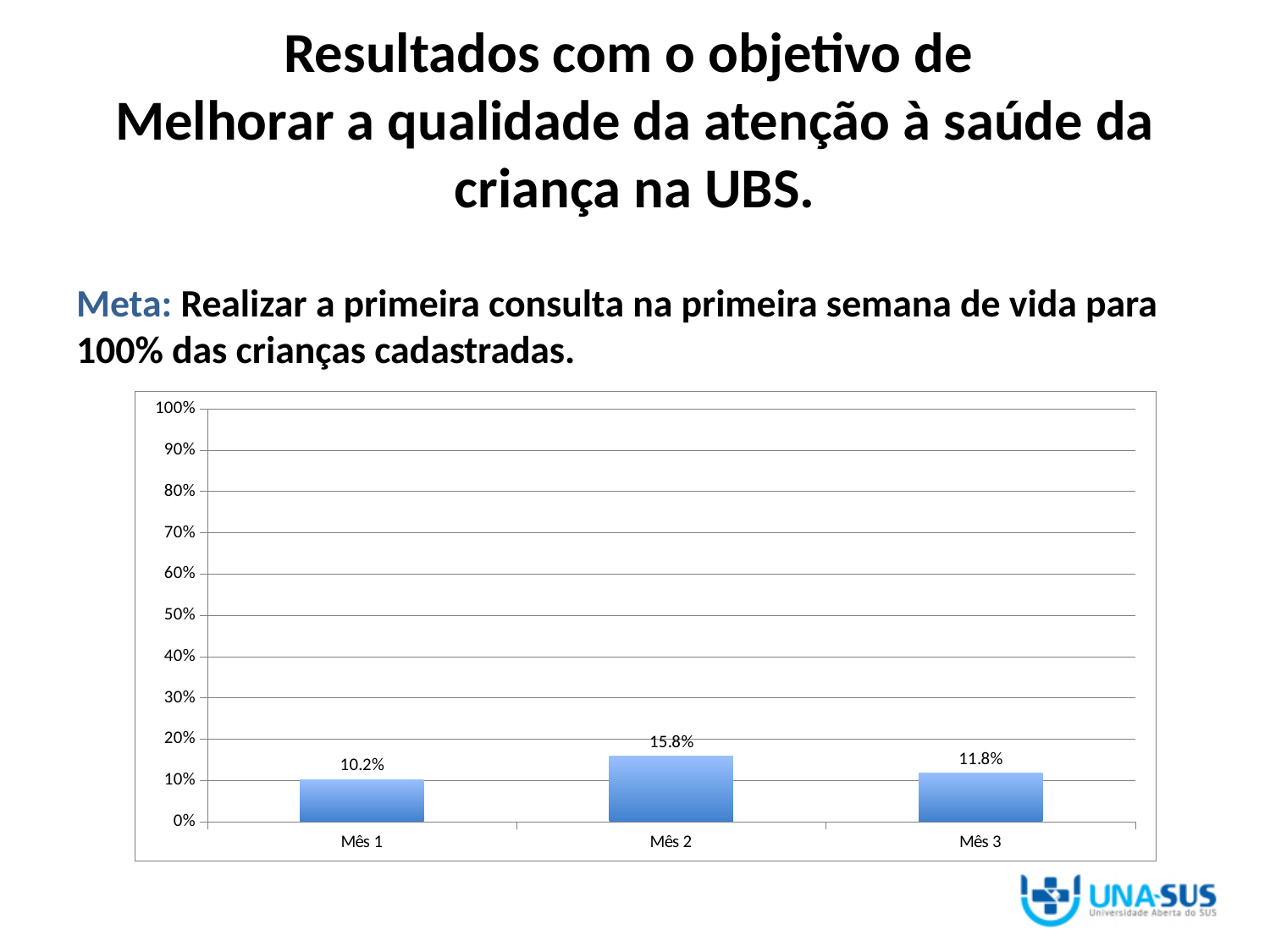
What kind of chart is shown on the slide? bar chart How many months are shown on the x axis? 3 Is the value for Mês 2 greater or less than 20%? less What is the maximum value shown on the y axis? 100% Which is larger, the value for Mês 3 or the value for Mês 1? Mês 3 What is the difference between the values for Mês 2 and Mês 1? 5.6% What is the difference between the values for Mês 2 and Mês 3? 4.0% Which month has the lowest value? Mês 1 What is the value for Mês 1? 10.2% What is the value for Mês 3? 11.8% What is the value for Mês 2? 15.8% Which month has the highest value? Mês 2